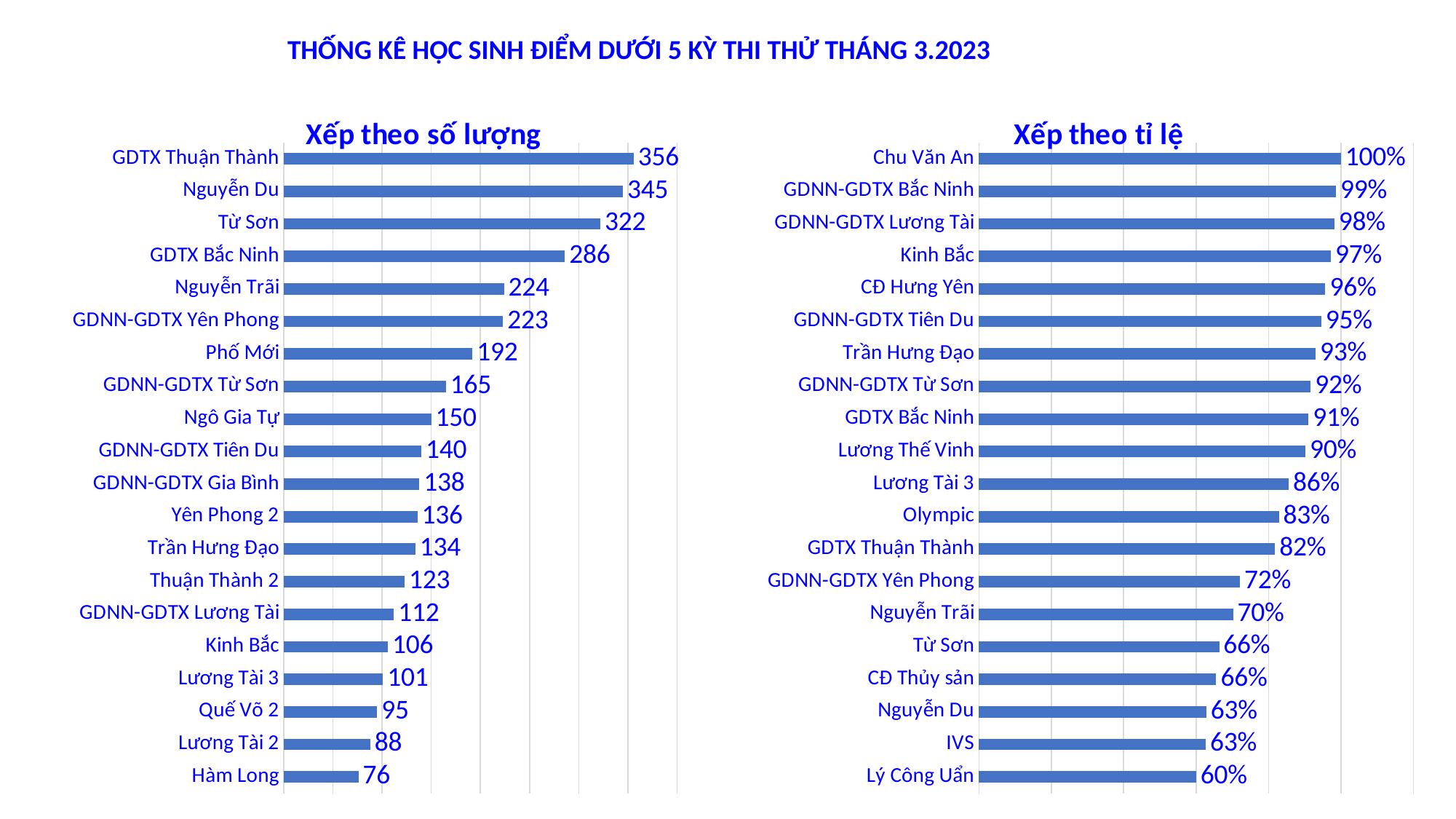
In the 'Xếp theo số lượng' chart, which category has the lowest value? Hàm Long In the 'Xếp theo tỉ lệ' chart, which category has the lowest value? Lý Công Uẩn In the 'Xếp theo tỉ lệ' chart, which is larger: the value for Olympic or the value for GDNN-GDTX Yên Phong? Olympic In the 'Xếp theo số lượng' chart, how many categories are shown? 20 In the 'Xếp theo tỉ lệ' chart, what is the difference between the values for Kinh Bắc and Nguyễn Trãi? 27% In the 'Xếp theo tỉ lệ' chart, which category has the highest value? Chu Văn An In the 'Xếp theo số lượng' chart, what is the difference between the values for Từ Sơn and GDTX Bắc Ninh? 36 What kind of chart is the 'Xếp theo tỉ lệ' chart? Bar chart In the 'Xếp theo số lượng' chart, which category has the highest value? GDTX Thuận Thành In the 'Xếp theo tỉ lệ' chart, what is the value for Lương Thế Vinh? 90% What is the title of the slide above the two charts? THỐNG KÊ HỌC SINH ĐIỂM DƯỚI 5 KỲ THI THỬ THÁNG 3.2023 In the 'Xếp theo số lượng' chart, what is the value for Nguyễn Du? 345